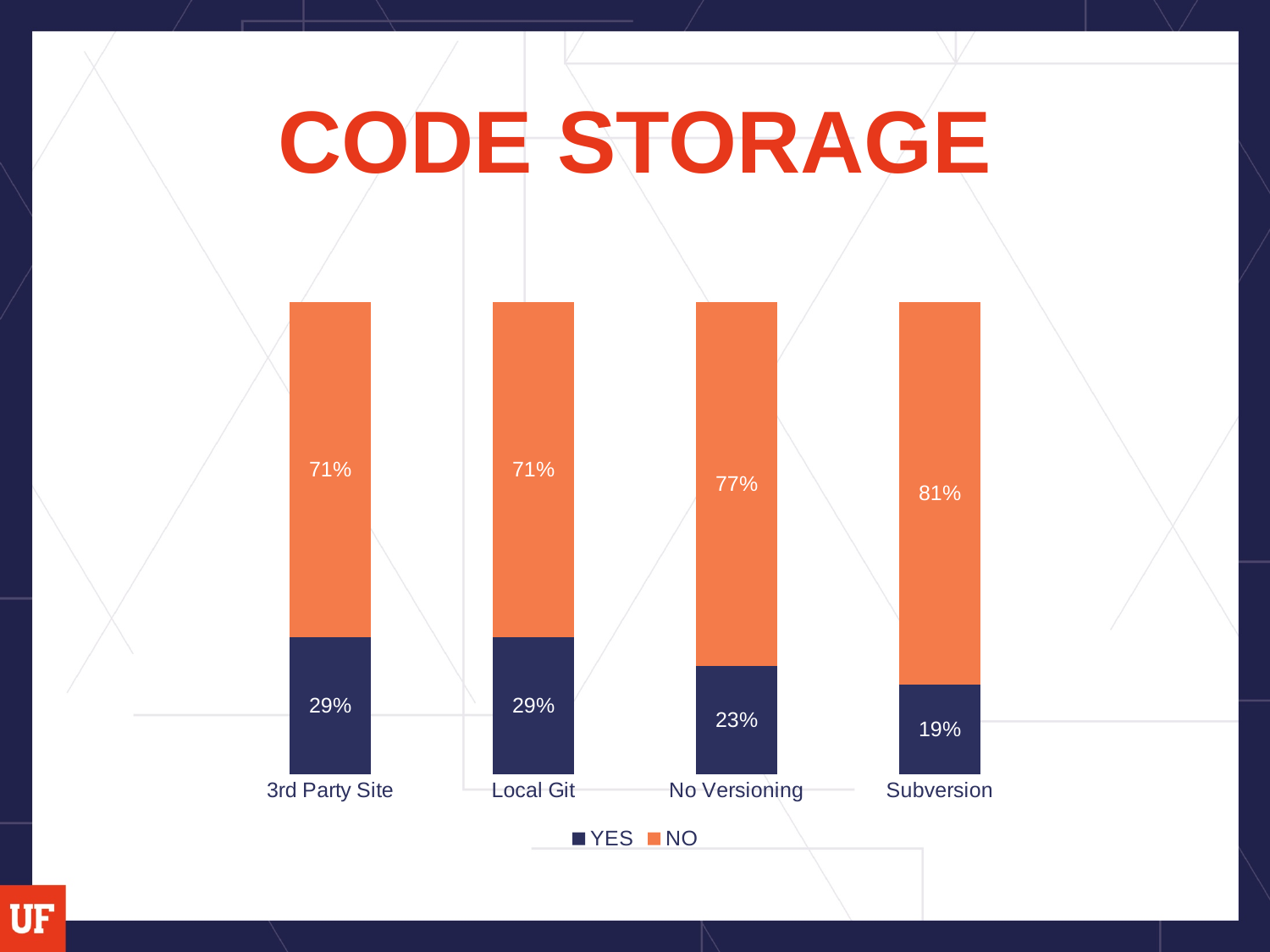
What is the total of the stacked bar for No Versioning? 100% How many series does the legend list? 2 What is the NO value for No Versioning? 77% What percentage of respondents answered YES for Subversion? 19% What is the YES value for Local Git? 29% Which category has the lowest YES percentage? Subversion What is the title of the chart? CODE STORAGE What is the difference between the NO value for Subversion and the NO value for 3rd Party Site? 10% How many categories are shown on the x axis? 4 Which is larger: the YES value for No Versioning or the YES value for Subversion? No Versioning Which category has the highest NO percentage? Subversion What kind of chart is shown on the slide? Stacked bar chart